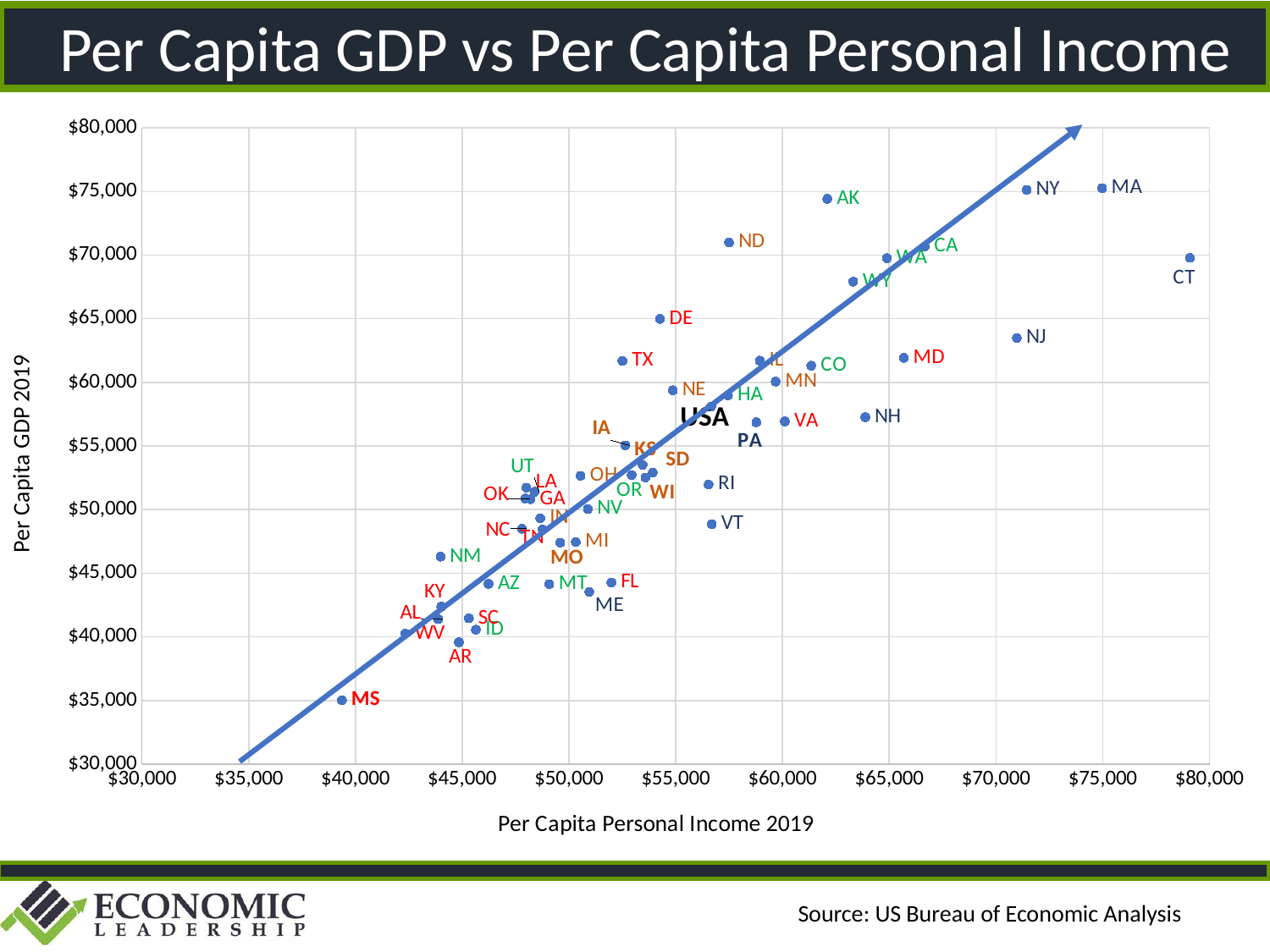
Do per capita GDP values generally rise or fall as per capita personal income increases along the x axis? rise What kind of chart is shown on the slide? Scatter chart Is the per capita GDP for VT greater or less than $50,000? less Which has the higher per capita GDP, DE or TX? DE Which state has the highest per capita personal income on the chart? CT What is the title of the y axis? Per Capita GDP 2019 Is the per capita personal income for CT greater or less than $75,000? greater Is the per capita GDP for MS greater or less than $40,000? less Which state has the lowest per capita GDP on the chart? MS What is the title of the x axis? Per Capita Personal Income 2019 Which state has the lowest per capita personal income on the chart? MS